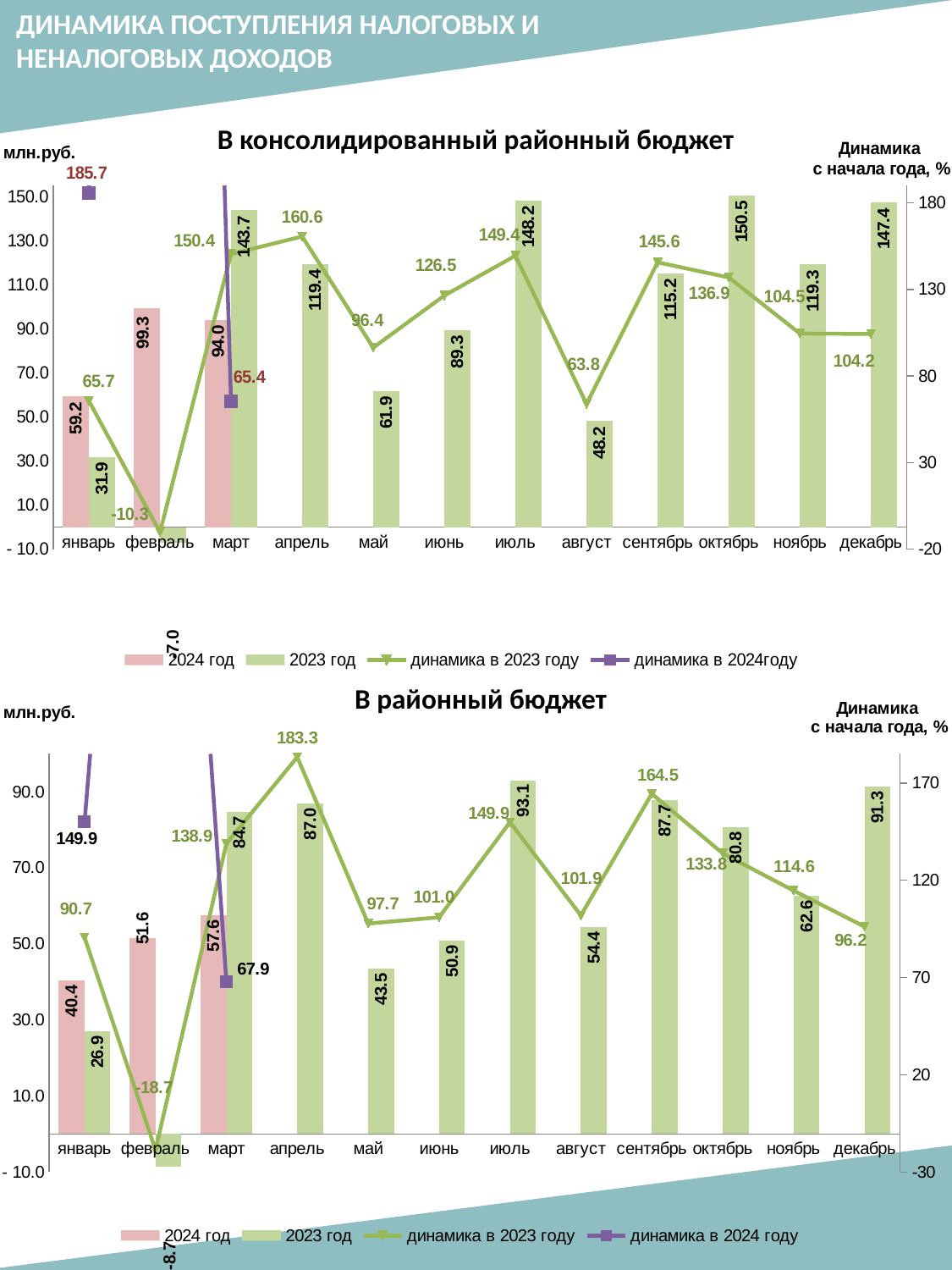
In the chart 'В районный бюджет', how many months are shown on the x axis? 12 In the chart 'В районный бюджет', what is the value of 'динамика в 2023 году' for апрель? 183.3 In the chart 'В консолидированный районный бюджет', what is the value of the 2024 год bar for февраль? 99.3 In the chart 'В консолидированный районный бюджет', what is the value of 'динамика в 2024году' for январь? 185.7 In the chart 'В районный бюджет', which is larger: the 2023 год bar for июль or for сентябрь? июль In the chart 'В районный бюджет', which month has the lowest 2023 год bar? февраль In the chart 'В консолидированный районный бюджет', which month has the highest 2023 год bar? октябрь In the chart 'В районный бюджет', what is the value of the 2023 год bar for декабрь? 91.3 In the chart 'В районный бюджет', what is the difference between the 2024 год bar for март and the 2024 год bar for январь? 17.2 In the chart 'В консолидированный районный бюджет', what is the value of the 2023 год bar for июль? 148.2 In the chart 'В консолидированный районный бюджет', what is the difference between the 2024 год and 2023 год bars for январь? 27.3 In the chart 'В консолидированный районный бюджет', how many series does the legend list? 4